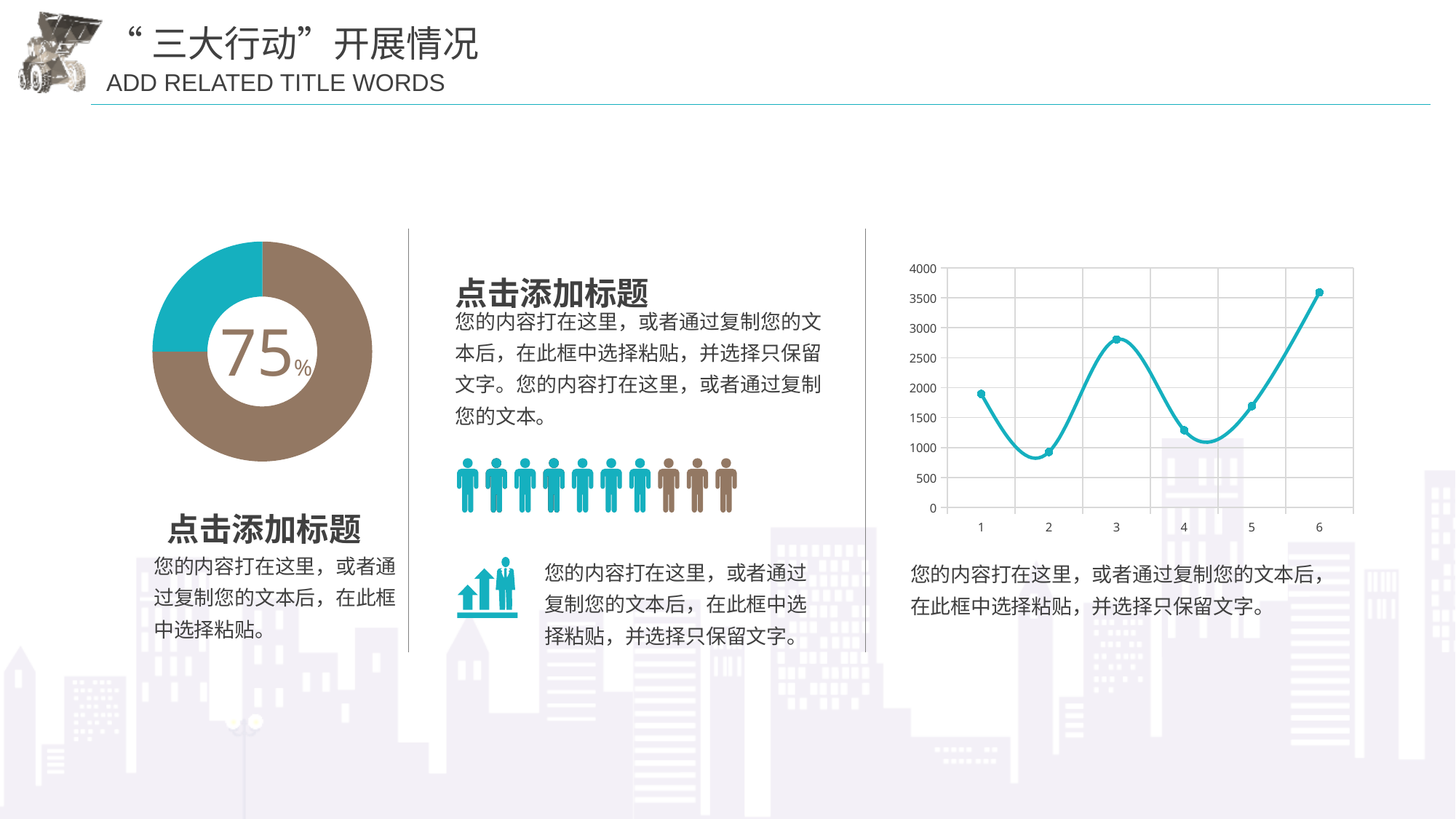
In the line chart on the right, which has the larger value, x = 3 or x = 4? 3 What type of chart is shown on the left side of the slide? donut chart In the line chart on the right, is the value at x = 2 greater or less than 1000? less In the line chart on the right, what is the maximum value shown on the y-axis? 4000 In the line chart on the right, which x-axis category has the highest value? 6 In the line chart on the right, which x-axis category has the lowest value? 2 In the line chart on the right, how many data points are plotted? 6 In the line chart on the right, is the value at x = 3 greater or less than 2500? greater What type of chart is shown on the right side of the slide? line chart In the line chart on the right, is the value at x = 6 greater or less than 3500? greater What percentage is printed in the centre of the donut chart on the left? 75% In the line chart on the right, which has the larger value, x = 1 or x = 5? 1